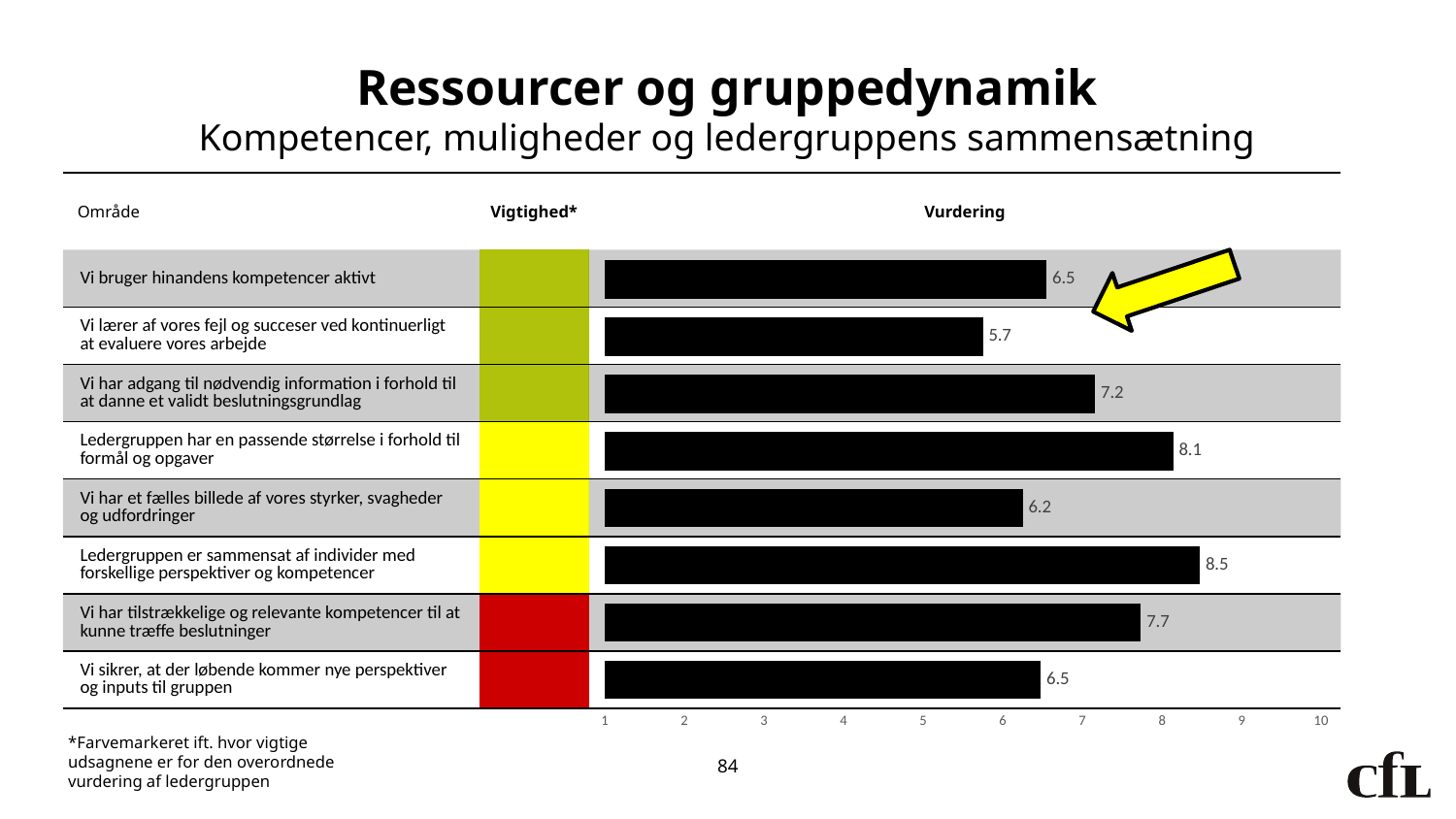
What is the Vurdering value for "Vi har tilstrækkelige og relevante kompetencer til at kunne træffe beslutninger"? 7.7 What is the difference between the Vurdering values for "Ledergruppen er sammensat af individer med forskellige perspektiver og kompetencer" and "Vi har et fælles billede af vores styrker, svagheder og udfordringer"? 2.3 Which area has the lowest Vurdering value? Vi lærer af vores fejl og succeser ved kontinuerligt at evaluere vores arbejde What is the Vurdering value for "Ledergruppen har en passende størrelse i forhold til formål og opgaver"? 8.1 What is the Vurdering value for "Vi lærer af vores fejl og succeser ved kontinuerligt at evaluere vores arbejde"? 5.7 Is the Vurdering value for "Vi har et fælles billede af vores styrker, svagheder og udfordringer" greater or less than 7? less How many areas are plotted in the chart? 8 Which has a higher Vurdering value: "Vi har adgang til nødvendig information i forhold til at danne et validt beslutningsgrundlag" or "Vi sikrer, at der løbende kommer nye perspektiver og inputs til gruppen"? Vi har adgang til nødvendig information i forhold til at danne et validt beslutningsgrundlag What is the maximum value shown on the chart's axis? 10 What is the Vurdering value for "Vi bruger hinandens kompetencer aktivt"? 6.5 What type of chart is used to show the Vurdering values? Bar chart Which area has the highest Vurdering value? Ledergruppen er sammensat af individer med forskellige perspektiver og kompetencer